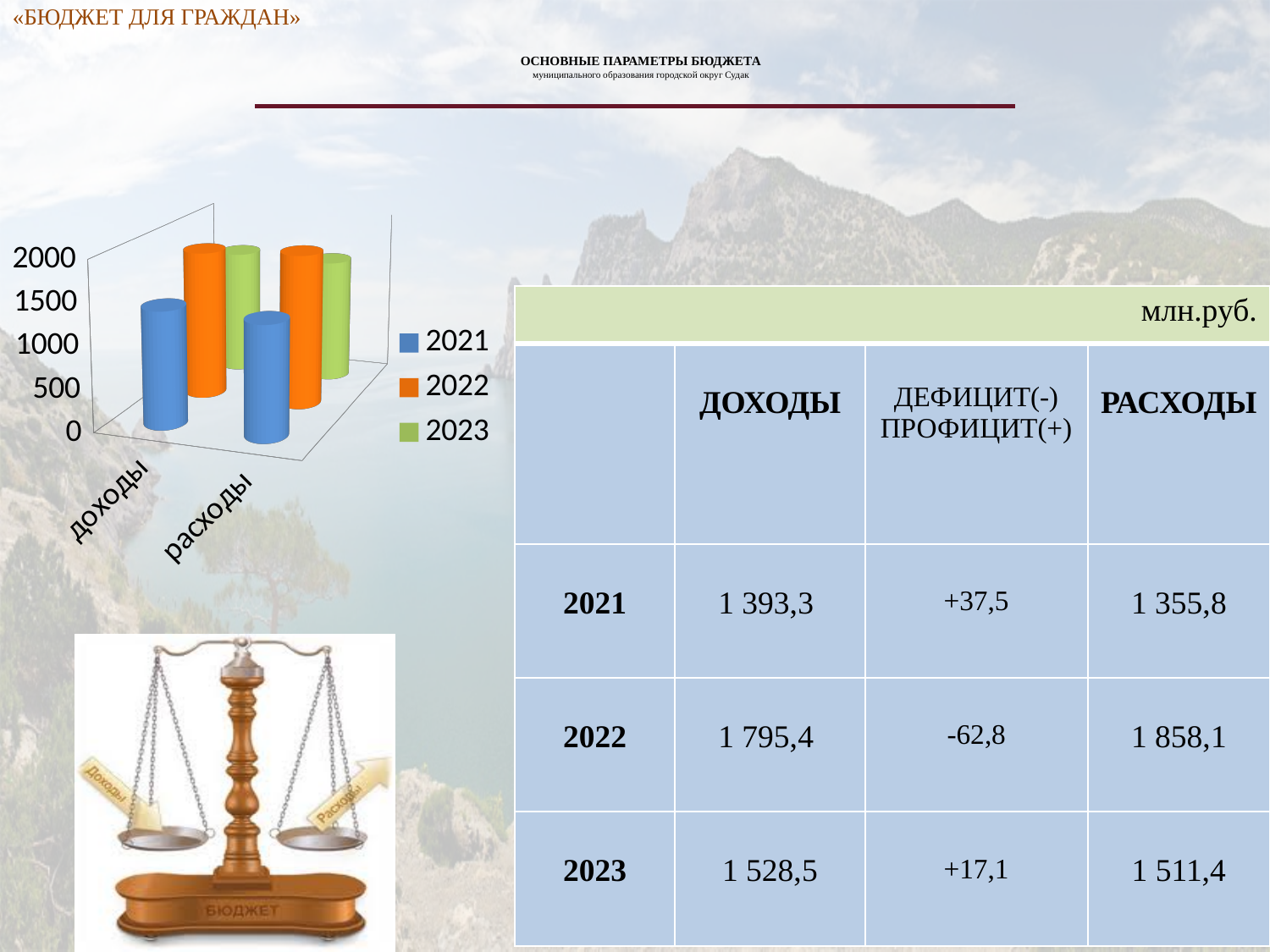
What kind of chart is shown on the slide? bar chart Which series is shown in green in the chart legend? 2023 How many categories are shown on the x axis of the chart? 2 For доходы, which is larger: the 2022 bar or the 2023 bar? 2022 Is the 2021 value for расходы greater or less than 1000? greater Which year has the highest bar for доходы? 2022 How many series does the chart legend list? 3 Is the 2022 value for доходы greater or less than 1500? greater Which series is shown in orange in the chart legend? 2022 Which year has the lowest bar for расходы? 2021 Is the 2022 value for расходы greater or less than 1500? greater